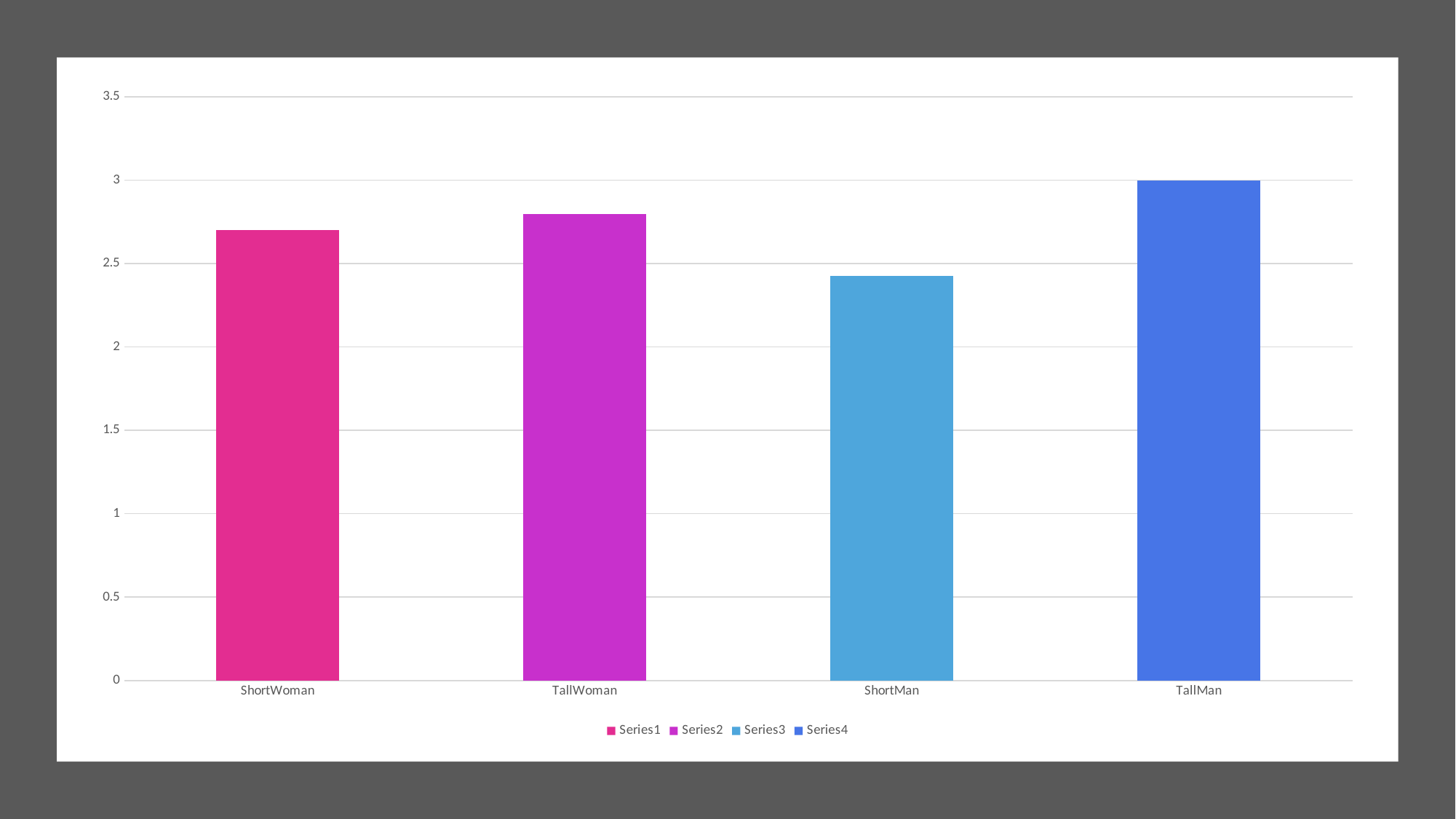
Is the value for ShortMan greater or less than 2.5? less Which category has the highest value? TallMan Which is larger, the value for TallMan or the value for TallWoman? TallMan What are the entries listed in the legend? Series1, Series2, Series3, Series4 Is the value for ShortWoman greater or less than 2.5? greater Which category has the lowest value? ShortMan What kind of chart is shown on the slide? bar chart Which is larger, the value for ShortWoman or the value for ShortMan? ShortWoman Is the value for TallWoman greater or less than 3? less How many categories are shown on the x axis? 4 What is the value for TallMan? 3 How many series does the legend list? 4